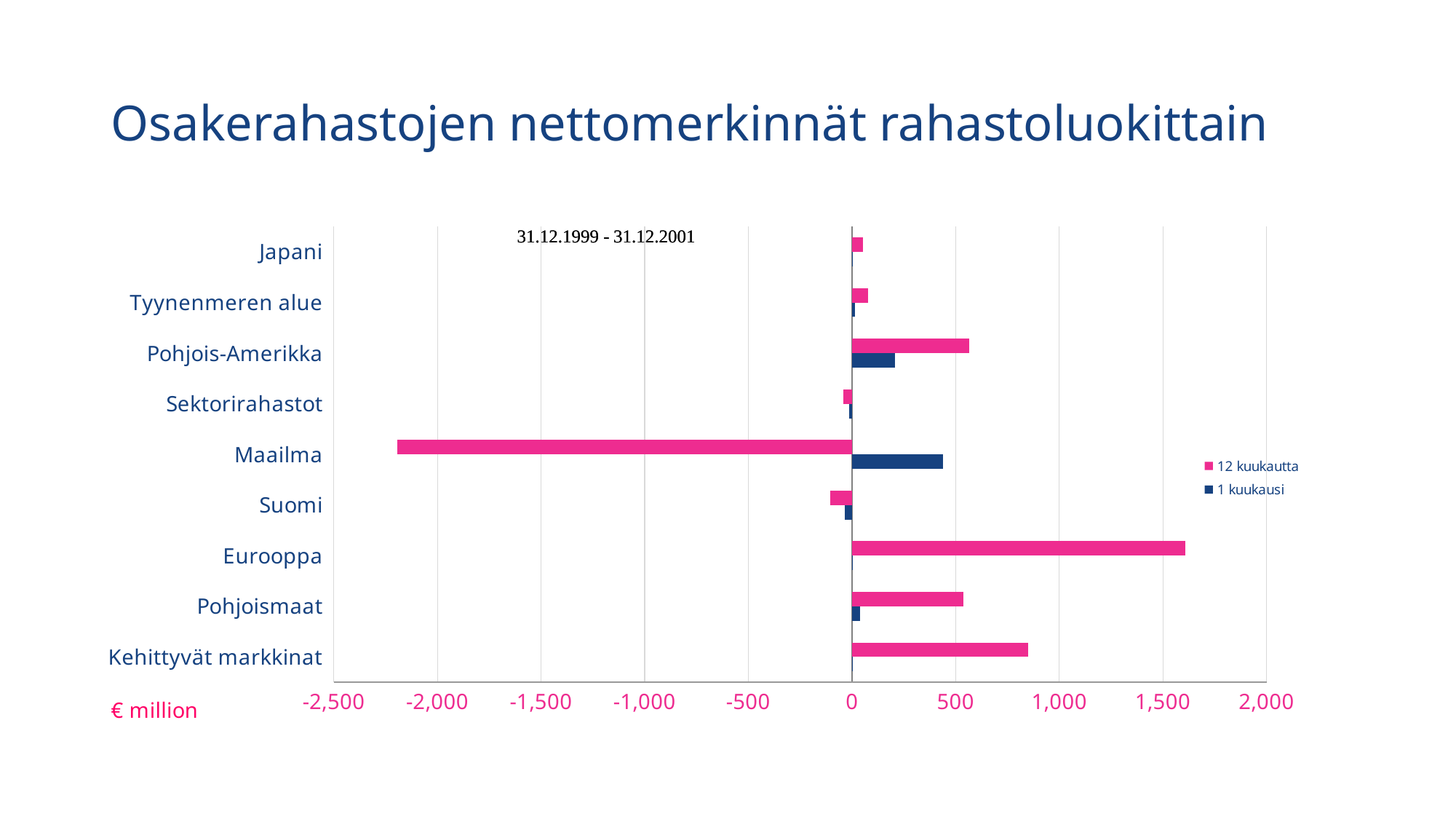
Is the 12 kuukautta value for Kehittyvät markkinat greater or less than 500? greater What unit is shown below the horizontal axis of the chart? € million How many fund categories are listed on the vertical axis of the chart? 9 How many series does the chart legend list? 2 What kind of chart is shown on the slide? Bar chart Is the 12 kuukautta value for Maailma greater or less than -2,000? less Which colour represents the 1 kuukausi series in the chart? Dark blue Which category has the highest value for the 12 kuukautta series? Eurooppa Is the 12 kuukautta value for Eurooppa greater or less than 1,500? greater Which is larger for the 12 kuukautta series: Kehittyvät markkinat or Pohjoismaat? Kehittyvät markkinat Which category has the highest value for the 1 kuukausi series? Maailma Which category has the lowest value for the 12 kuukautta series? Maailma